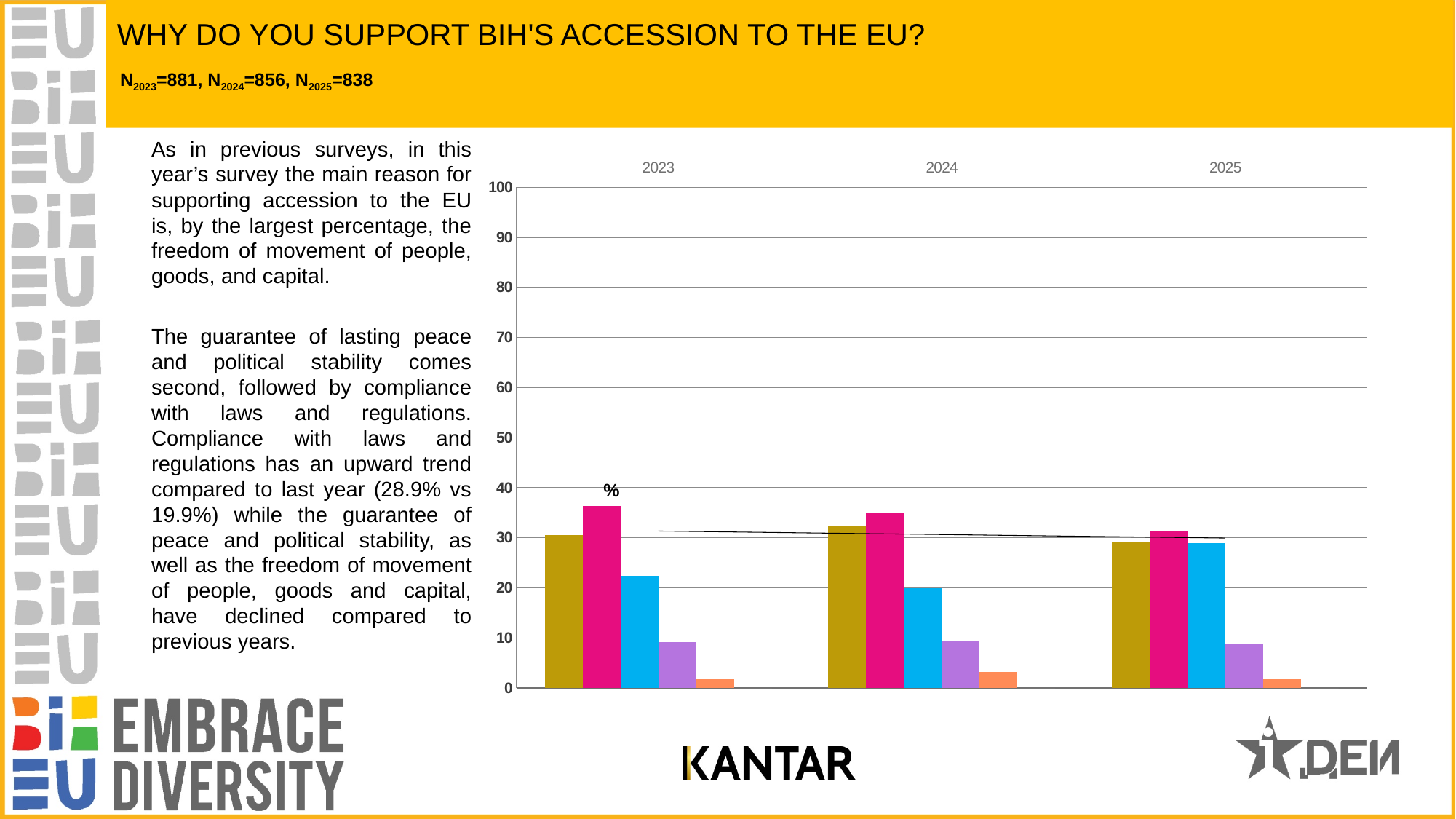
Is the value of the cyan bar for 2023 greater or less than 30? less Is the value of the orange bar for 2024 greater or less than 10? less Which bar is the tallest in the 2023 group? the magenta bar Is the value of the magenta bar for 2023 greater or less than 30? greater How many bars are plotted in each year group of the chart? 5 How many year groups are shown along the x axis of the chart? 3 Which years are shown along the x axis of the chart? 2023, 2024, 2025 Which bar is the shortest in the 2025 group? the orange bar Does the magenta bar rise or fall from 2023 to 2025? fall What kind of chart is shown on the slide? bar chart